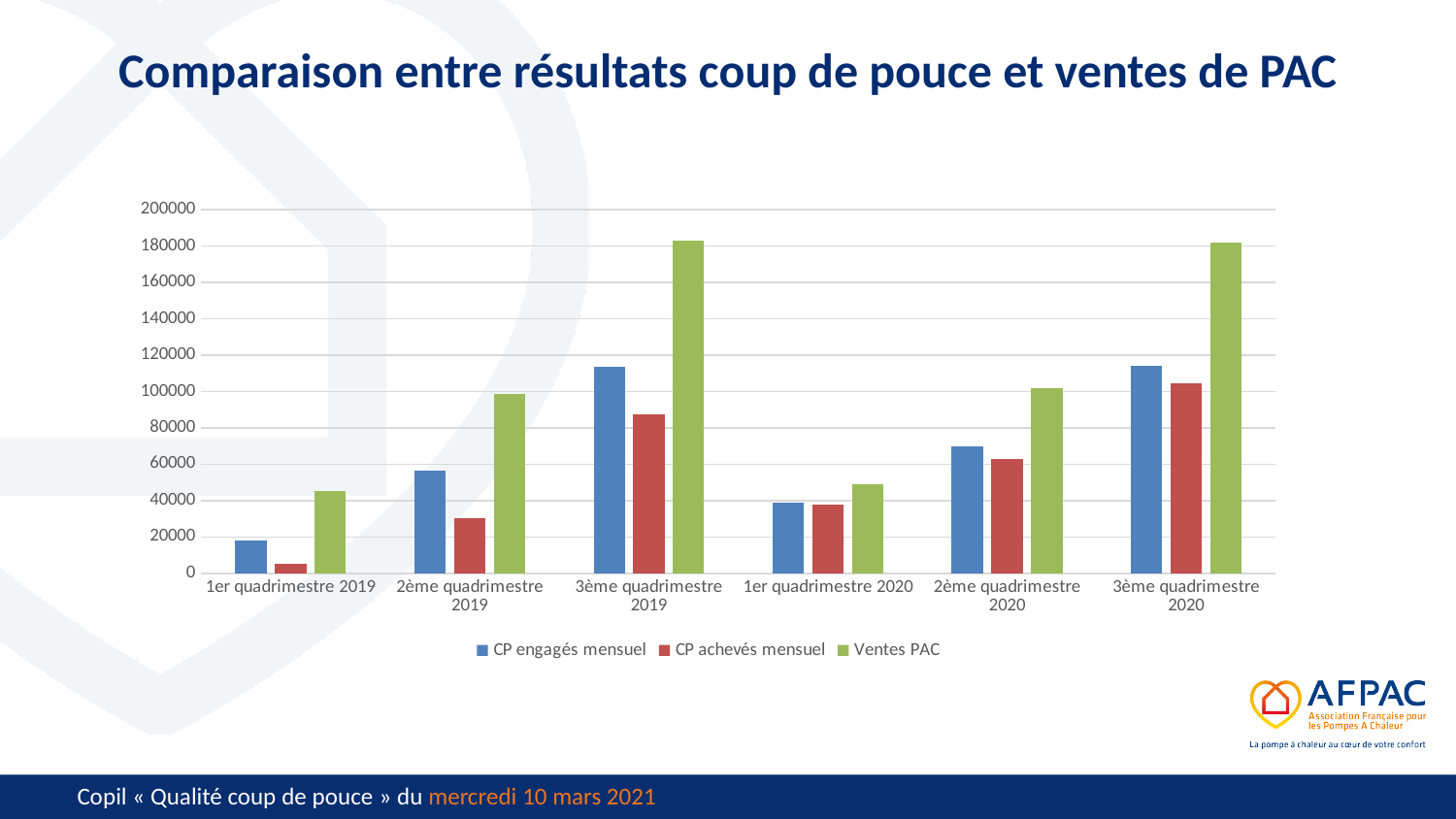
How many quadrimestre categories are shown on the x axis? 6 Is the value for Ventes PAC in 2ème quadrimestre 2020 greater or less than 80000? greater Which category has the lowest value for CP achevés mensuel? 1er quadrimestre 2019 How many series does the legend list? 3 Do the Ventes PAC values rise or fall across the three quadrimestres of 2019? rise Is the value for Ventes PAC in 3ème quadrimestre 2019 greater or less than 160000? greater Which category has the lowest value for Ventes PAC? 1er quadrimestre 2019 Is the value for CP achevés mensuel in 1er quadrimestre 2019 greater or less than 20000? less What kind of chart is shown on the slide? bar chart In 3ème quadrimestre 2019, which is larger: Ventes PAC or CP engagés mensuel? Ventes PAC What is the title of the chart? Comparaison entre résultats coup de pouce et ventes de PAC